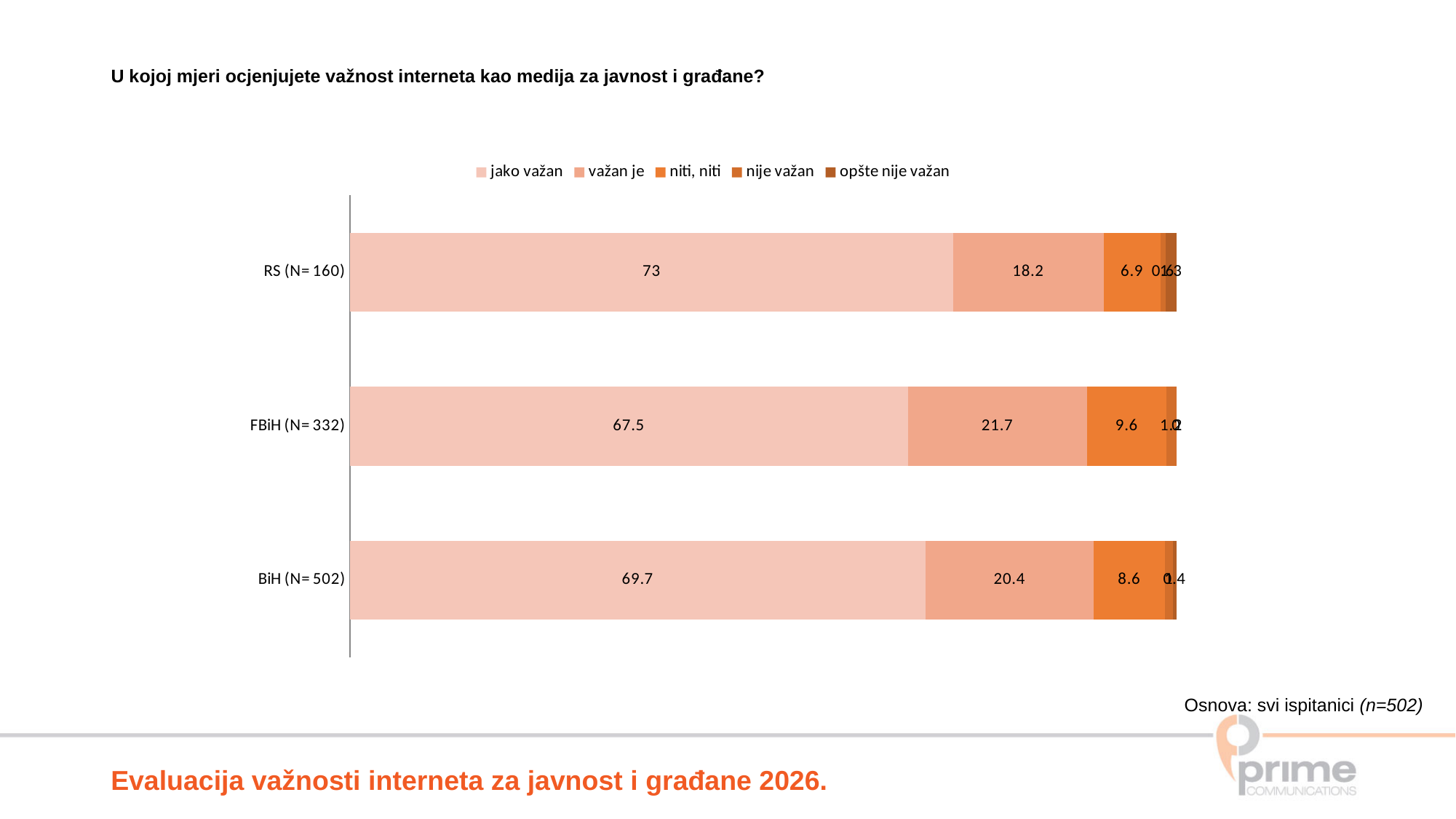
Which category has the lowest value for 'važan je'? RS (N= 160) What kind of chart is shown on the slide? Stacked bar chart What is the value for 'niti, niti' for BiH (N= 502)? 8.6 What is the difference between the 'jako važan' values for RS (N= 160) and FBiH (N= 332)? 5.5 How many series does the legend list? 5 Which category has the highest value for 'jako važan'? RS (N= 160) Which is larger: the 'niti, niti' value for RS (N= 160) or for FBiH (N= 332)? FBiH (N= 332) What is the value for 'niti, niti' for FBiH (N= 332)? 9.6 What is the value for 'jako važan' for RS (N= 160)? 73 What is the value for 'važan je' for FBiH (N= 332)? 21.7 What is the value for 'jako važan' for BiH (N= 502)? 69.7 How many categories are shown on the chart? 3